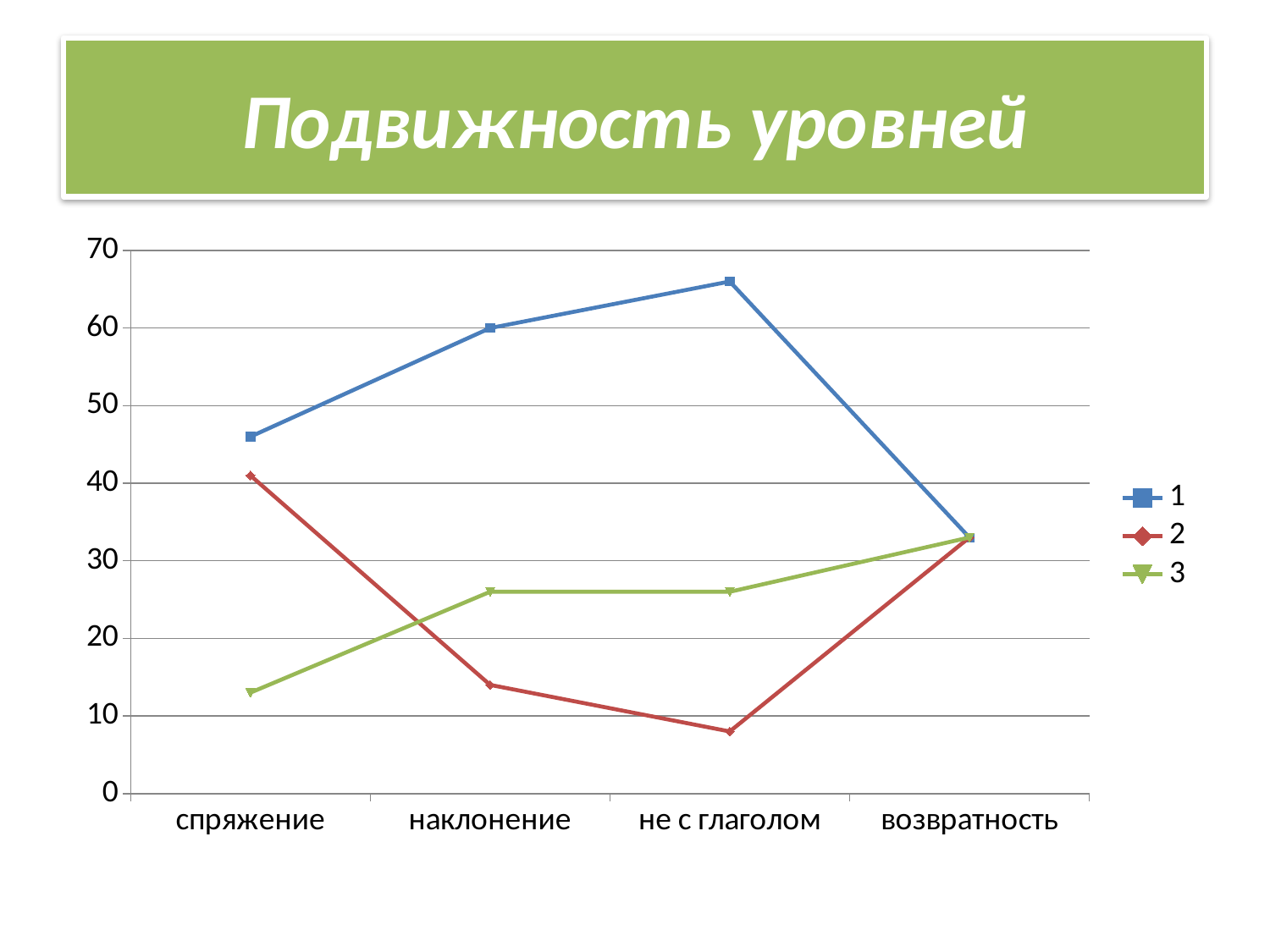
For which category does series 1 reach its highest value? не с глаголом Is the value of series 3 for наклонение greater or less than 30? less What is the value of series 1 for наклонение? 60 Is the value of series 1 for не с глаголом greater or less than 60? greater What is the title of the slide? Подвижность уровней How many categories are shown on the x axis? 4 Does series 2 rise or fall from спряжение to не с глаголом? fall For which category does series 2 have its lowest value? не с глаголом Is the value of series 2 for не с глаголом greater or less than 10? less How many series does the legend list? 3 What kind of chart is shown on the slide? line chart For наклонение, which series has the larger value, series 1 or series 2? 1